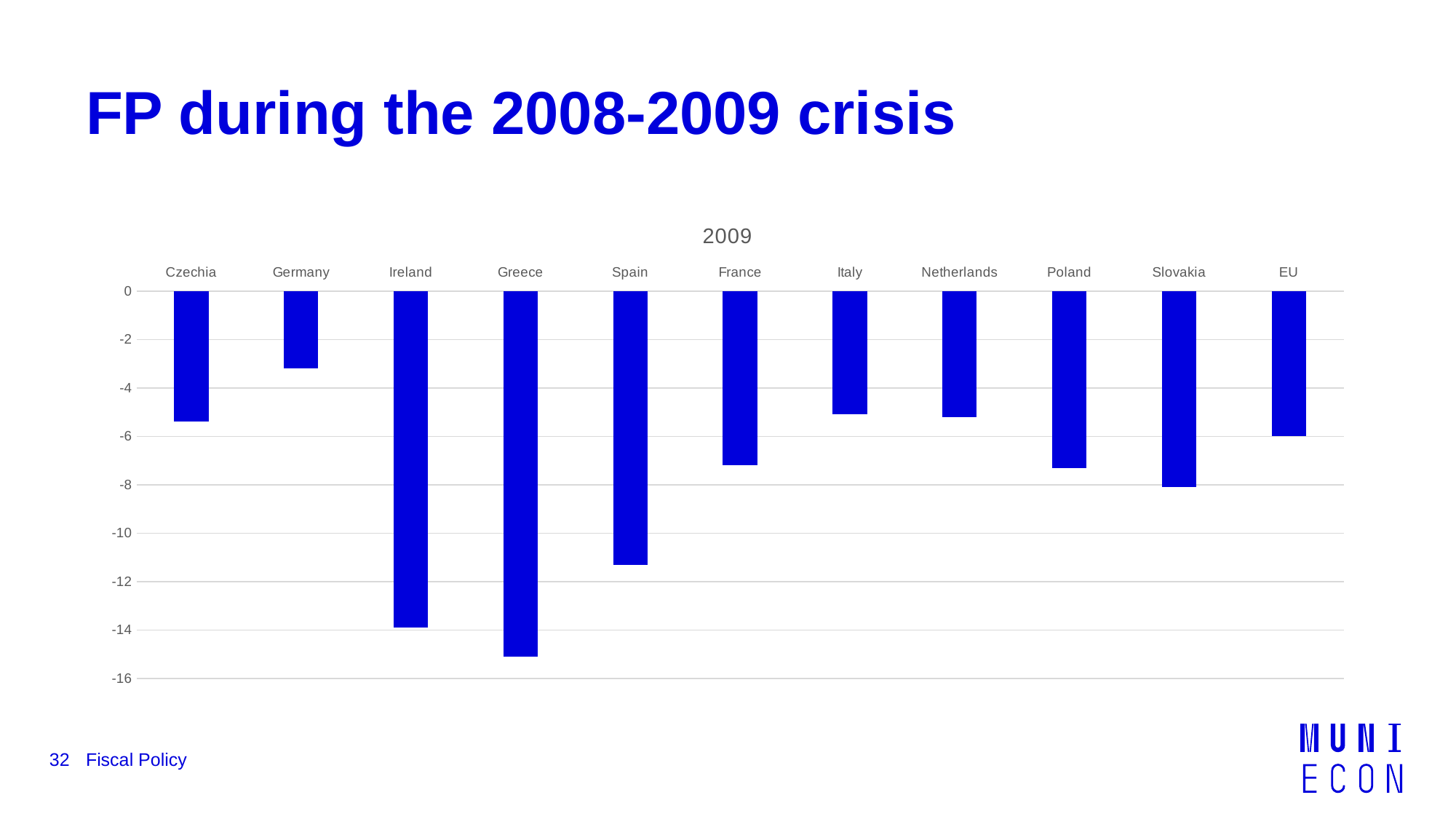
Which has the larger value, Ireland or Spain? Spain Which category has the lowest (most negative) value in the chart? Greece How many categories are shown on the x axis of the chart? 11 What kind of chart is shown on the slide? bar chart What is the title of the chart? 2009 Which category has the highest value (closest to zero) in the chart? Germany Is the value for Spain greater or less than -10? less What colour are the bars in the chart? blue Is the value for Ireland greater or less than -12? less Is the value for Germany greater or less than -4? greater